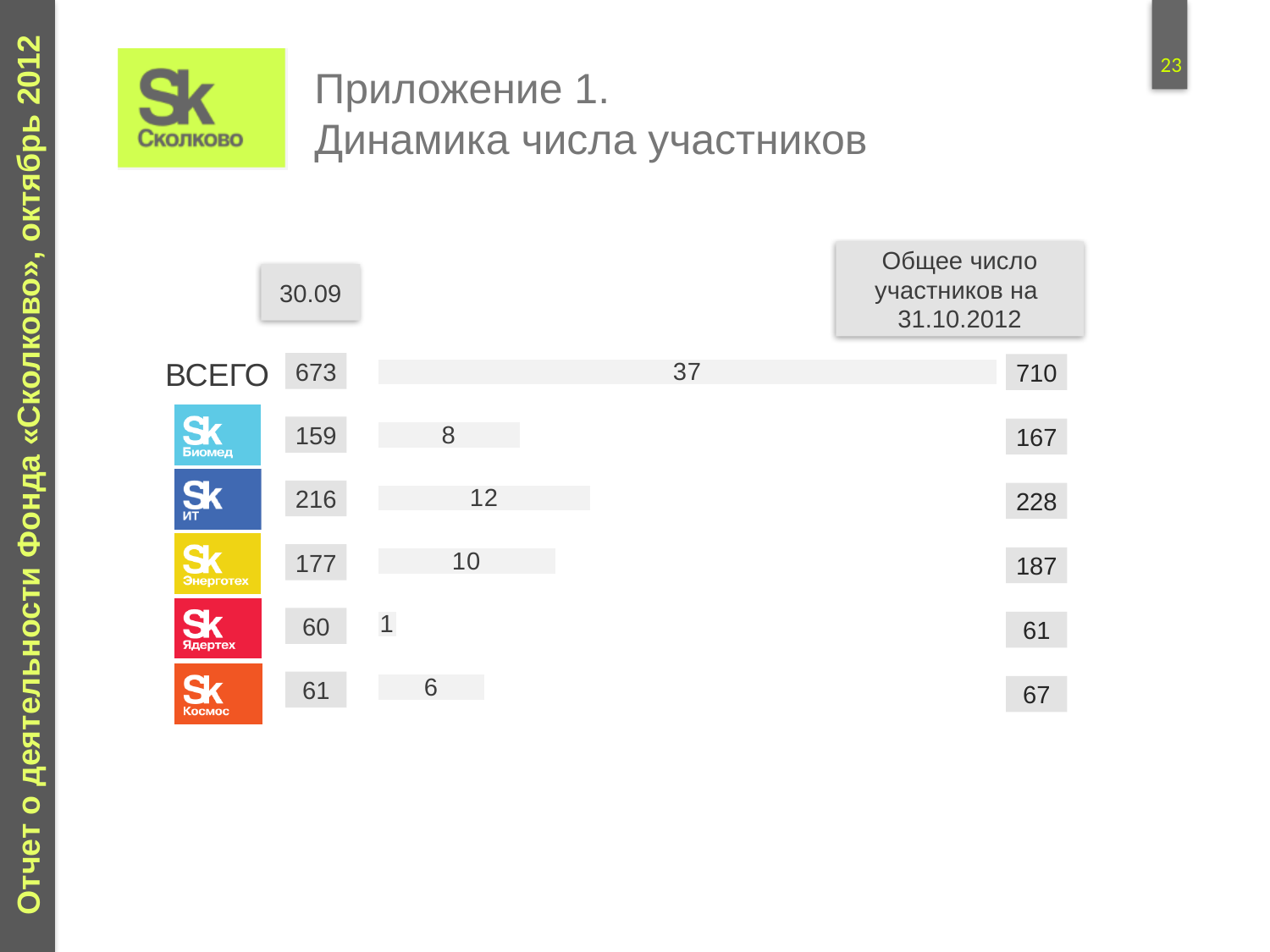
What is the value of the bar for ИТ? 12 Excluding the ВСЕГО row, which cluster has the highest bar value? ИТ What is the number shown for Энерготех in the 30.09 column? 177 How many cluster rows are shown below the ВСЕГО row? 5 Which has a larger bar value, Биомед or Космос? Биомед What is the value of the bar for Биомед? 8 What is the value of the bar for ВСЕГО? 37 What is the total number of participants for ИТ as of 31.10.2012? 228 What is the difference between the bar values for ИТ and Энерготех? 2 What kind of chart is shown on the slide? bar chart What is the value of the bar for Космос? 6 Which cluster has the lowest bar value? Ядертех